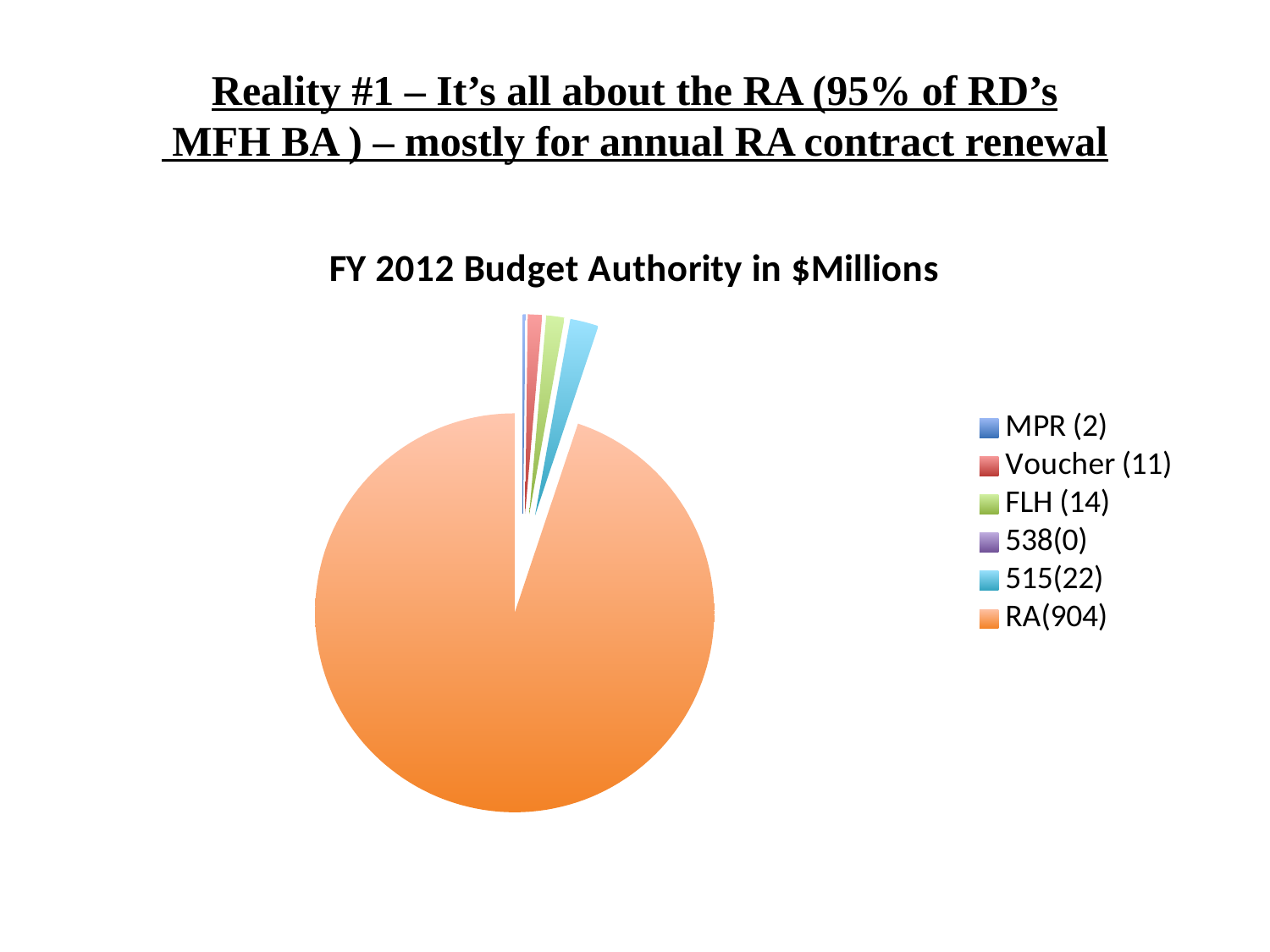
How many categories does the legend of the pie chart list? 6 What type of chart is shown on the slide? pie chart Which category has the smallest value in the legend? 538 What is the value shown for Voucher in the legend? 11 Which category has the largest slice of the pie? RA What is the value shown for 515 in the legend? 22 What is the title of the chart? FY 2012 Budget Authority in $Millions What is the value shown for FLH in the legend? 14 What is the total of all the values listed in the legend? 953 What is the value shown for RA in the legend? 904 Which is larger, the value for FLH or the value for Voucher? FLH What is the difference between the values for RA and 515? 882